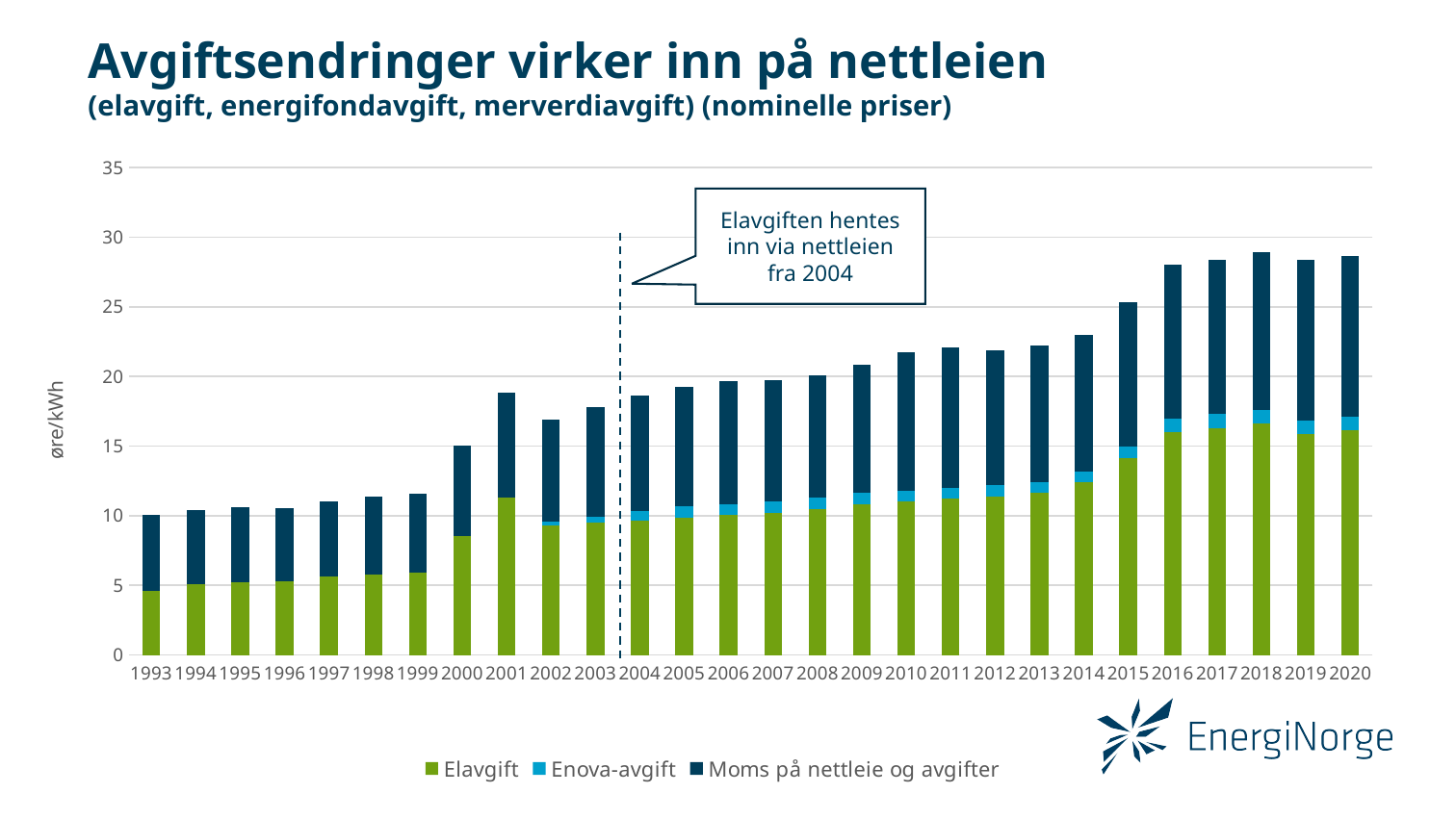
How many years are shown along the x axis of the chart? 28 Which year has the larger total bar, 2001 or 2002? 2001 What kind of chart is shown on the slide? Stacked bar chart Which year has the lowest total bar in the chart? 1993 Is the total value for 1993 greater or less than 15? less What unit is shown on the y axis of the chart? øre/kWh Which series are listed in the chart legend? Elavgift, Enova-avgift, Moms på nettleie og avgifter How many series does the legend list? 3 Is the Elavgift value for 2020 greater or less than 15? greater Do the total bar values generally rise or fall from 1993 to 2020? rise Is the total value for 2010 greater or less than 20? greater